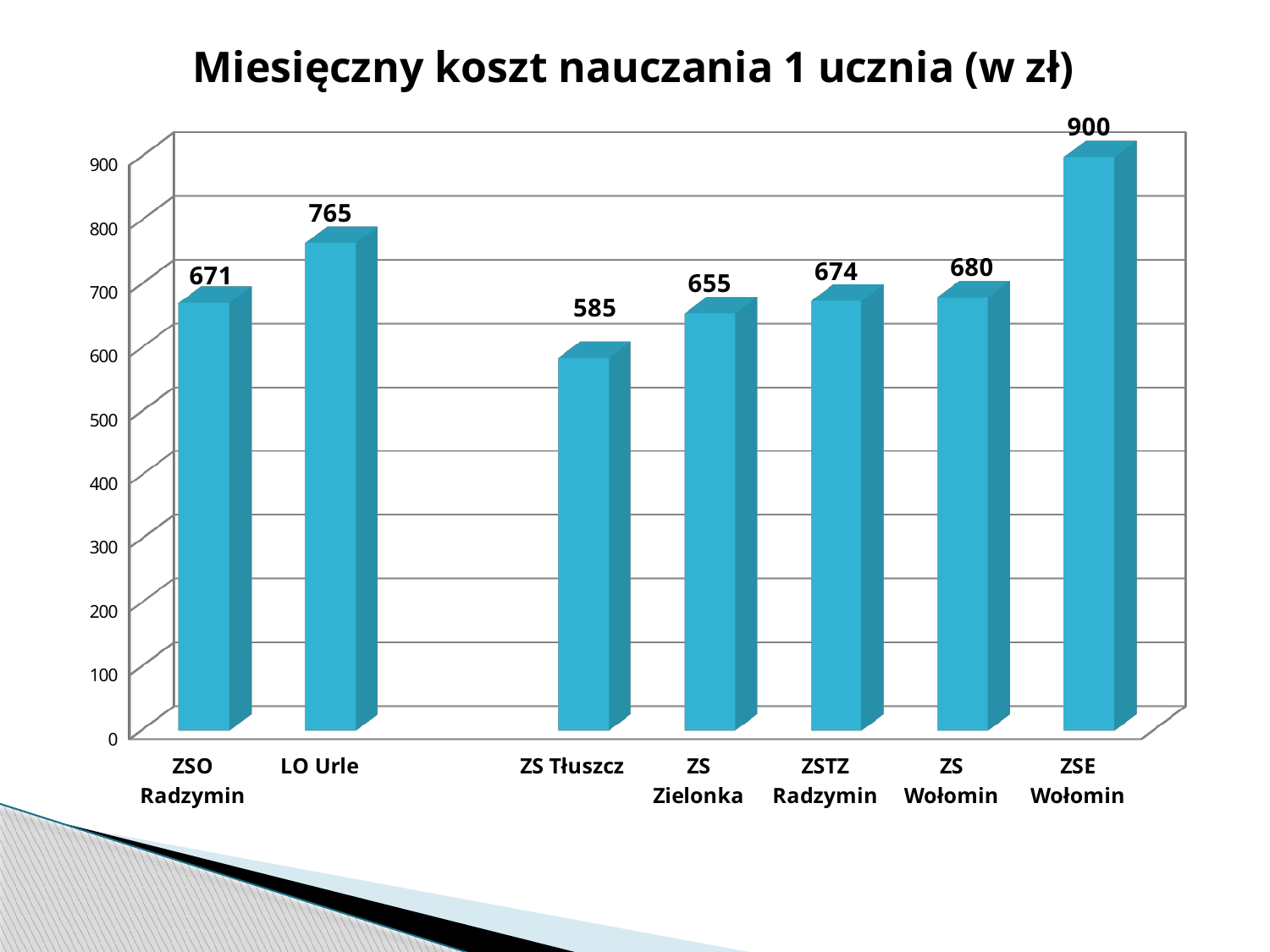
What is the value for LO Urle? 765 How many categories are shown on the chart? 7 What is the value for ZS Zielonka? 655 Which is larger, the value for ZS Wołomin or the value for ZSTZ Radzymin? ZS Wołomin What is the title of the chart? Miesięczny koszt nauczania 1 ucznia (w zł) What is the value for ZSO Radzymin? 671 What kind of chart is shown on the slide? Bar chart What is the difference between the values for ZSE Wołomin and ZS Tłuszcz? 315 Which category has the lowest value? ZS Tłuszcz What is the value for ZS Tłuszcz? 585 What is the difference between the values for LO Urle and ZSO Radzymin? 94 Which category has the highest value? ZSE Wołomin